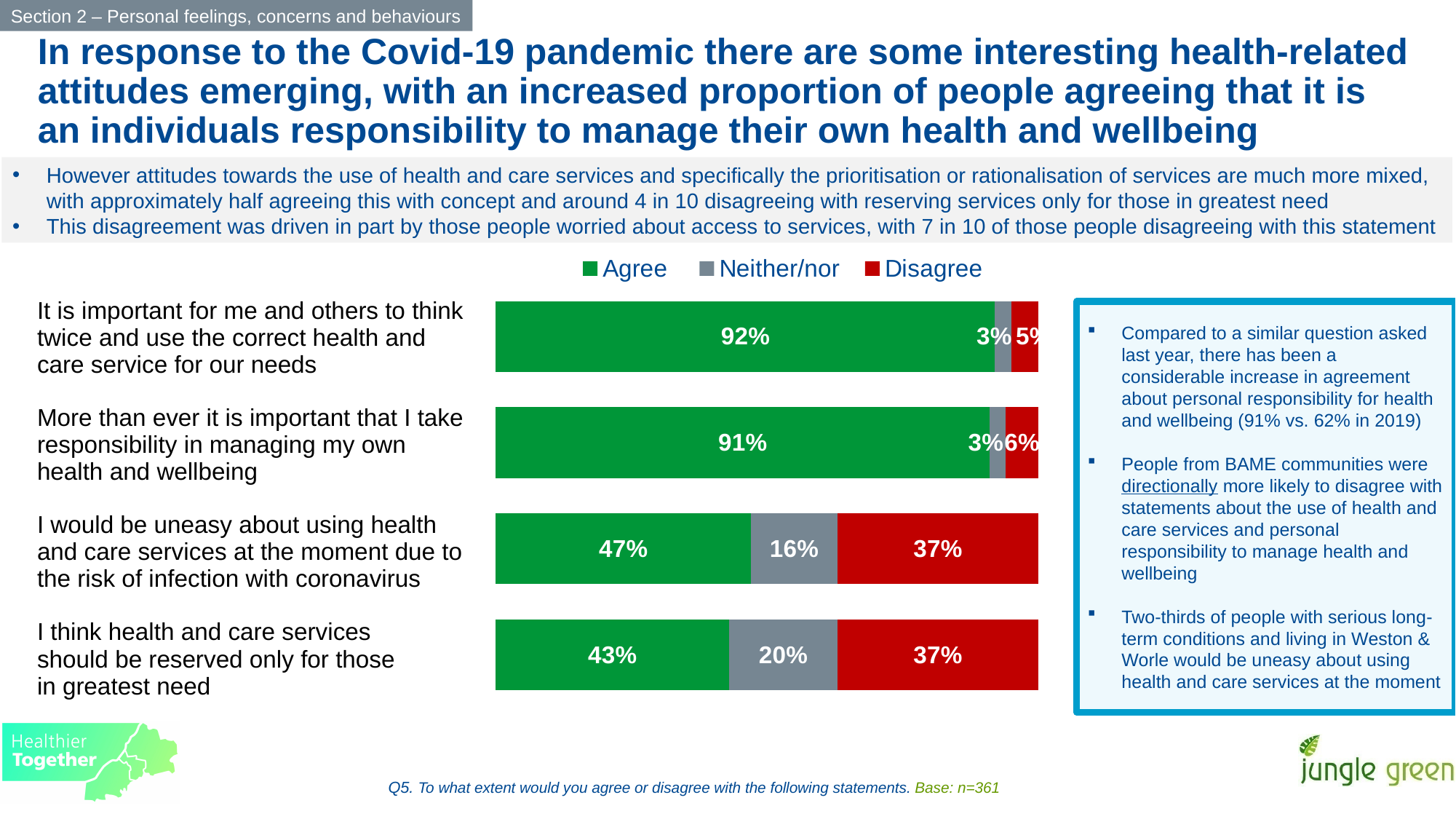
What is the difference between the Agree percentage for the statement about being uneasy about using health and care services and the Agree percentage for the statement about reserving services for those in greatest need? 4% How many statements are shown in the chart? 4 Which statement has the highest Agree percentage? It is important for me and others to think twice and use the correct health and care service for our needs What percentage disagree that health and care services should be reserved only for those in greatest need? 37% What kind of chart is shown on the slide? Stacked bar chart Which statement has the lowest Agree percentage? I think health and care services should be reserved only for those in greatest need What percentage agree that it is important for me and others to think twice and use the correct health and care service for our needs? 92% Which colour represents Disagree in the chart? Red What percentage answered Neither/nor for the statement about being uneasy about using health and care services due to the risk of infection with coronavirus? 16% What percentage agree that more than ever it is important that I take responsibility in managing my own health and wellbeing? 91% Is the Neither/nor percentage larger for the statement about being uneasy about using services or for the statement about reserving services for those in greatest need? I think health and care services should be reserved only for those in greatest need How many series does the legend list? 3